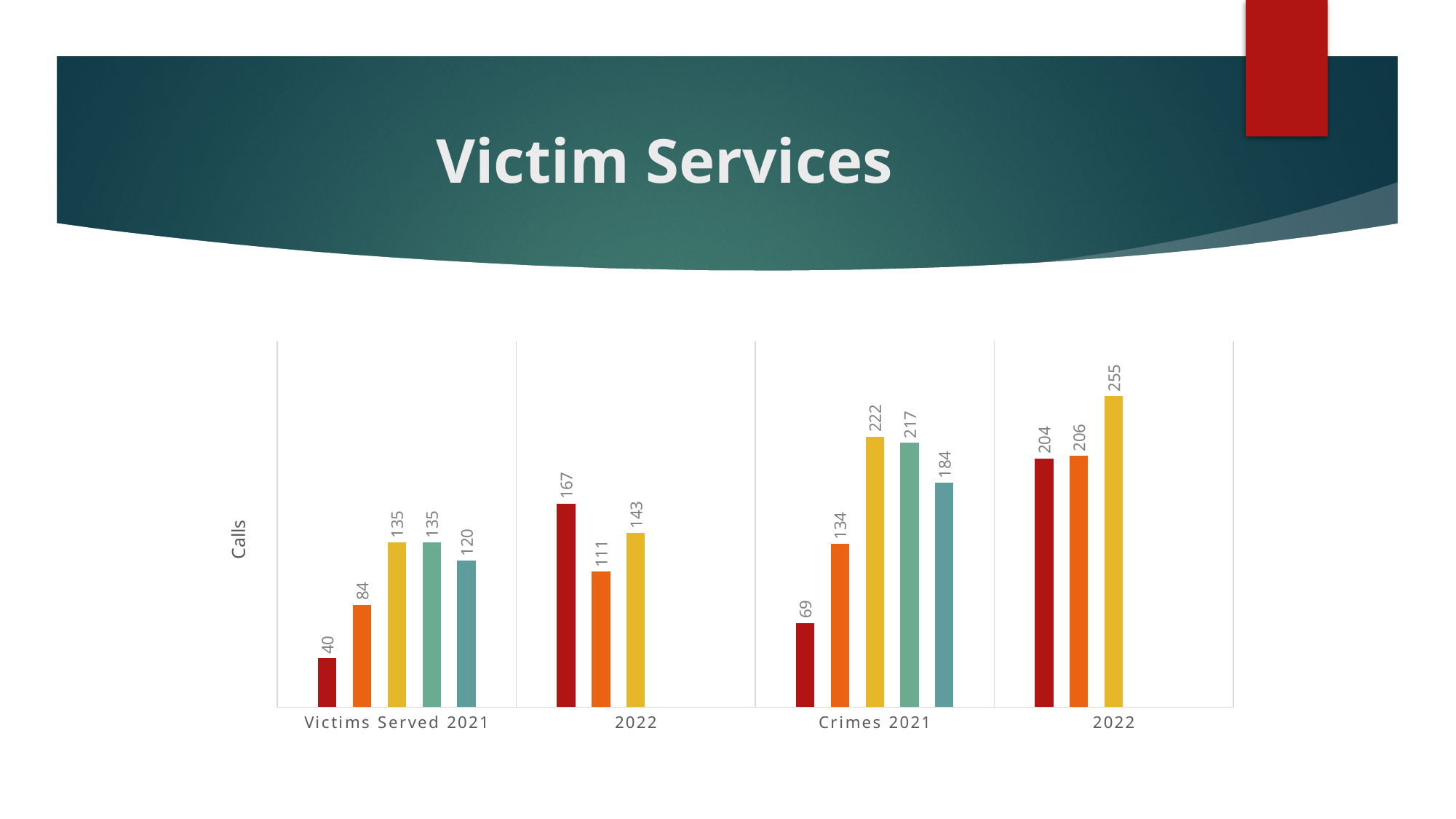
What is the value of the orange bar in the 2022 group that follows Victims Served 2021? 111 What is the value of the yellow bar in the Crimes 2021 group? 222 Which bar has the highest value in the whole chart, and what is it? The yellow bar in the rightmost 2022 group, 255 What is the value of the first (dark red) bar in the Victims Served 2021 group? 40 How many category groups are shown along the x axis of the chart? 4 In the rightmost 2022 group, how much larger is the yellow bar than the dark red bar? 51 What is the lowest value shown in the chart? 40 What kind of chart is shown on the slide? bar chart What is the value of the teal (last) bar in the Crimes 2021 group? 184 Which is larger: the orange bar in Victims Served 2021 or the orange bar in the 2022 group next to it? The orange bar in the 2022 group (111) What is the label on the vertical axis of the chart? Calls In the Crimes 2021 group, what is the difference between the yellow bar (222) and the green bar (217)? 5